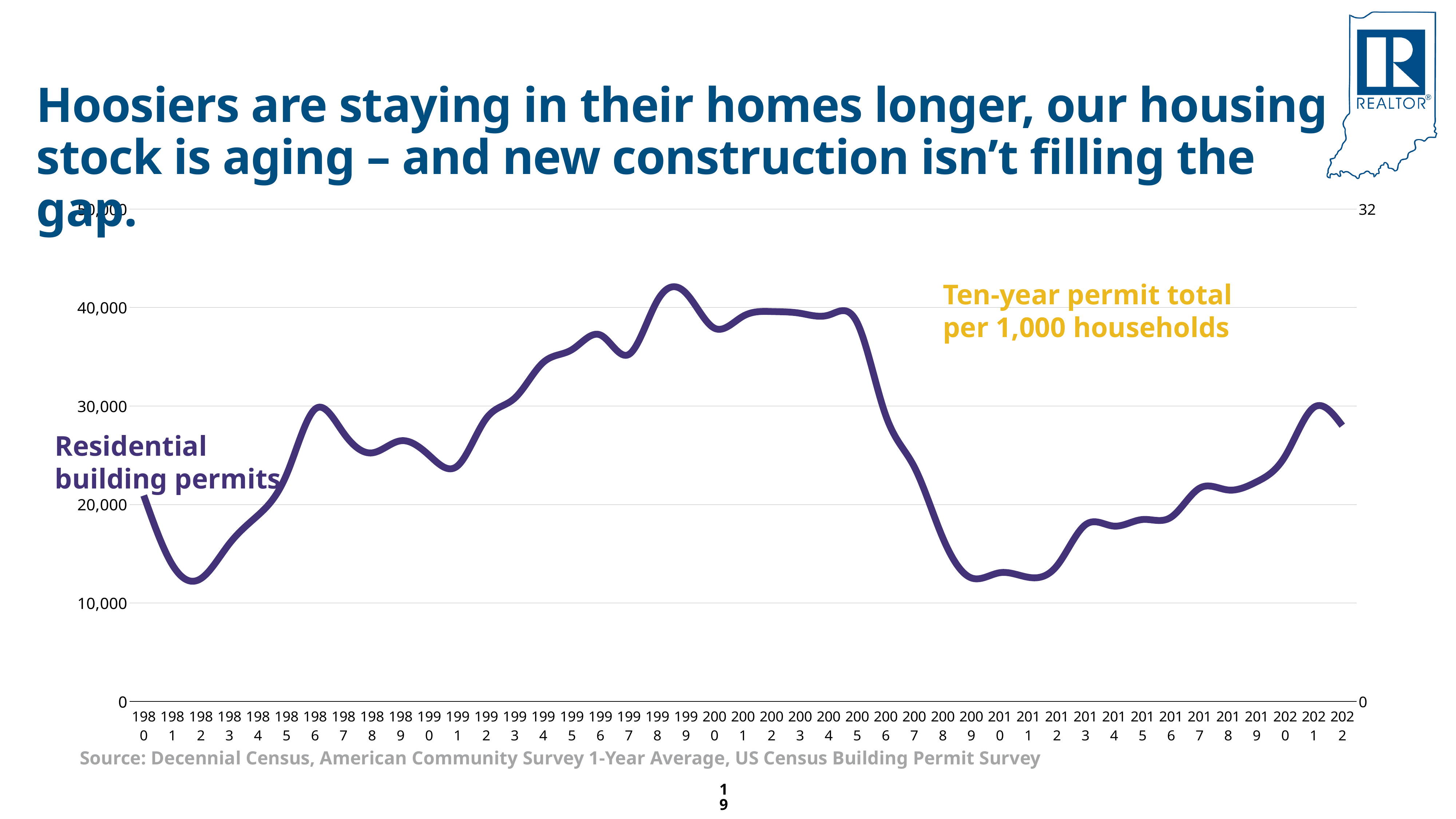
Which year has the highest value for residential building permits? 1999 What is the top tick value on the right-hand vertical axis? 32 Is the value for residential building permits in 2017 greater or less than 20,000? greater Is the value for residential building permits in 1994 greater or less than 30,000? greater What is the first year shown on the x axis? 1980 What kind of chart is shown on the slide? line chart Is the value for residential building permits in 1982 greater or less than 20,000? less Do residential building permits rise or fall from 2005 to 2009? fall Which year has the larger value for residential building permits, 1999 or 2009? 1999 Which year has the larger value for residential building permits, 1982 or 1986? 1986